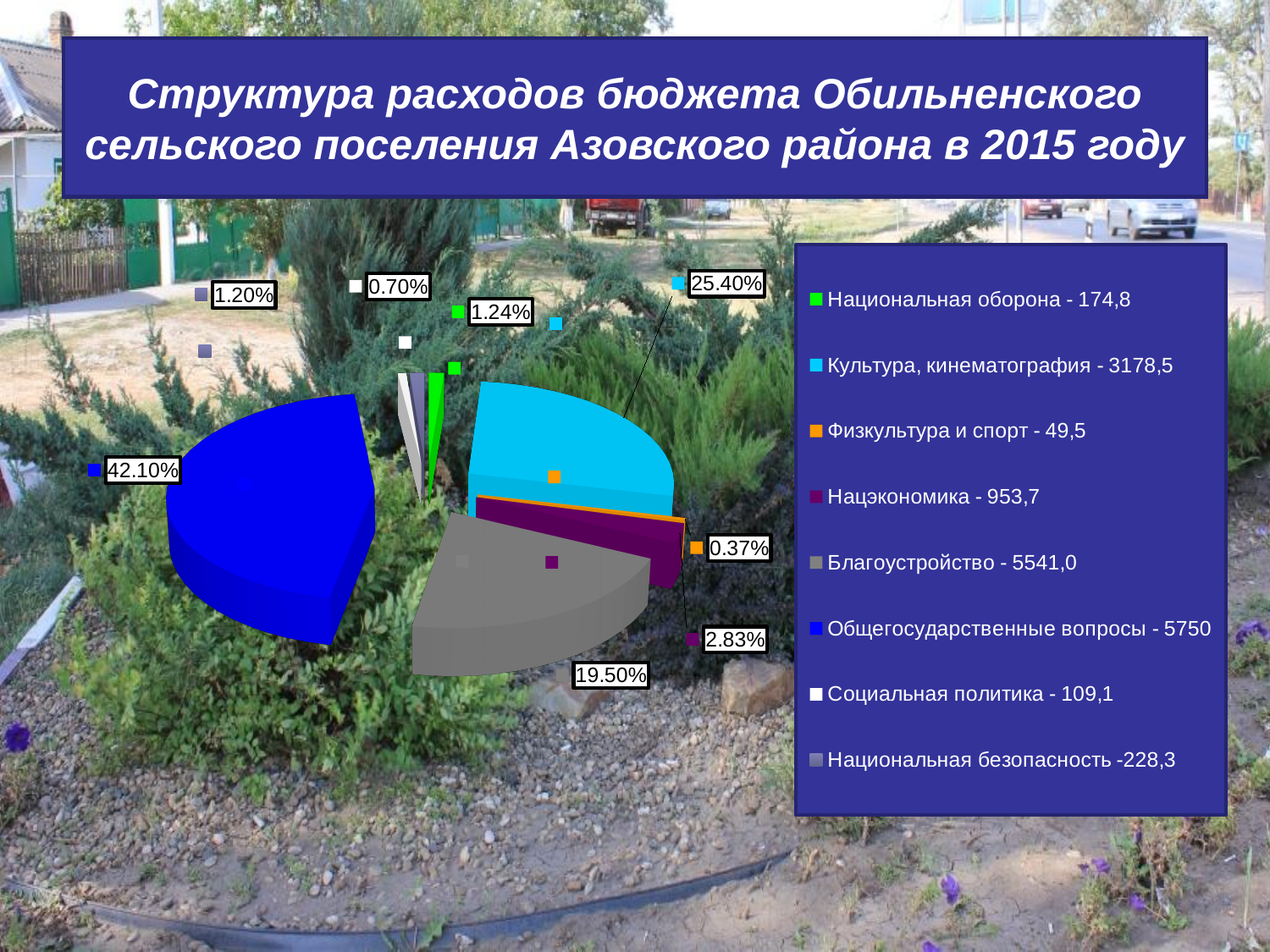
Which slice is larger: Благоустройство or Нацэкономика? Благоустройство What is the difference between the percentage labels for Общегосударственные вопросы and Культура, кинематография? 16.70% What percentage label is shown for the Культура, кинематография slice? 25.40% What kind of chart is shown on the slide? pie chart What value is given in the legend for Нацэкономика? 953,7 Which category has the smallest percentage label on the pie? Физкультура и спорт Which category has the largest slice of the pie? Общегосударственные вопросы What percentage label is shown for the Общегосударственные вопросы slice? 42.10% What percentage label is shown for the Благоустройство slice? 19.50% What value is given in the legend for Национальная безопасность? 228,3 What percentage label is shown for the Физкультура и спорт slice? 0.37% How many categories does the legend of the pie chart list? 8